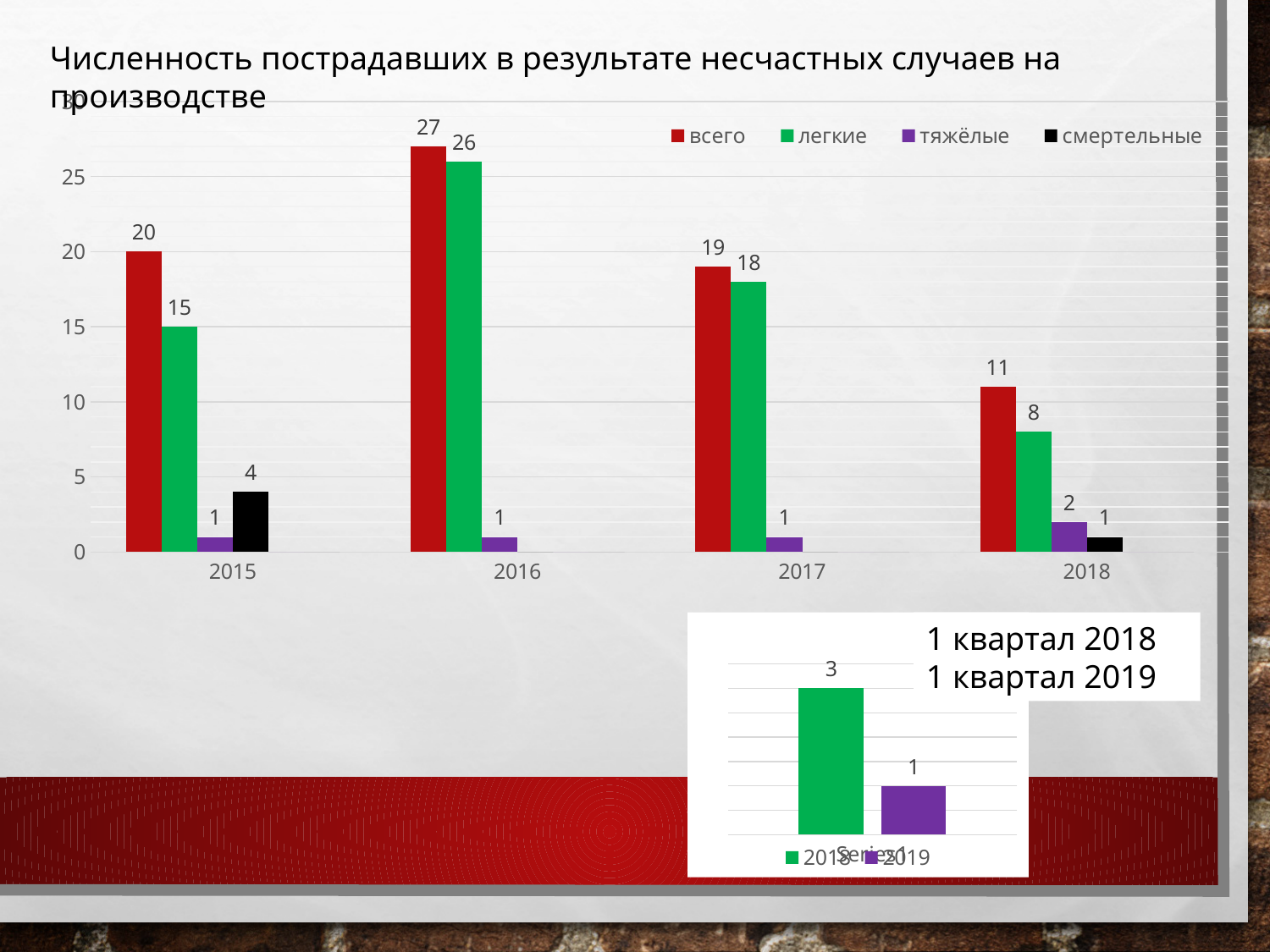
In the main chart, what is the value for всего in 2016? 27 In the small chart at the bottom right, what is the value of the green bar? 3 In the main chart, which year has the highest value for всего? 2016 In the main chart, which year has the lowest value for легкие? 2018 In the main chart, does the value for всего rise or fall from 2016 to 2018? fall In the main chart, what is the value for смертельные in 2015? 4 In the main chart, which is larger: всего in 2017 or всего in 2018? всего in 2017 In the main chart, what is the difference between всего and легкие in 2015? 5 What kind of chart is the main chart? bar chart In the main chart, how many series does the legend list? 4 In the main chart, what is the value for легкие in 2018? 8 In the main chart, how many years are shown on the x axis? 4